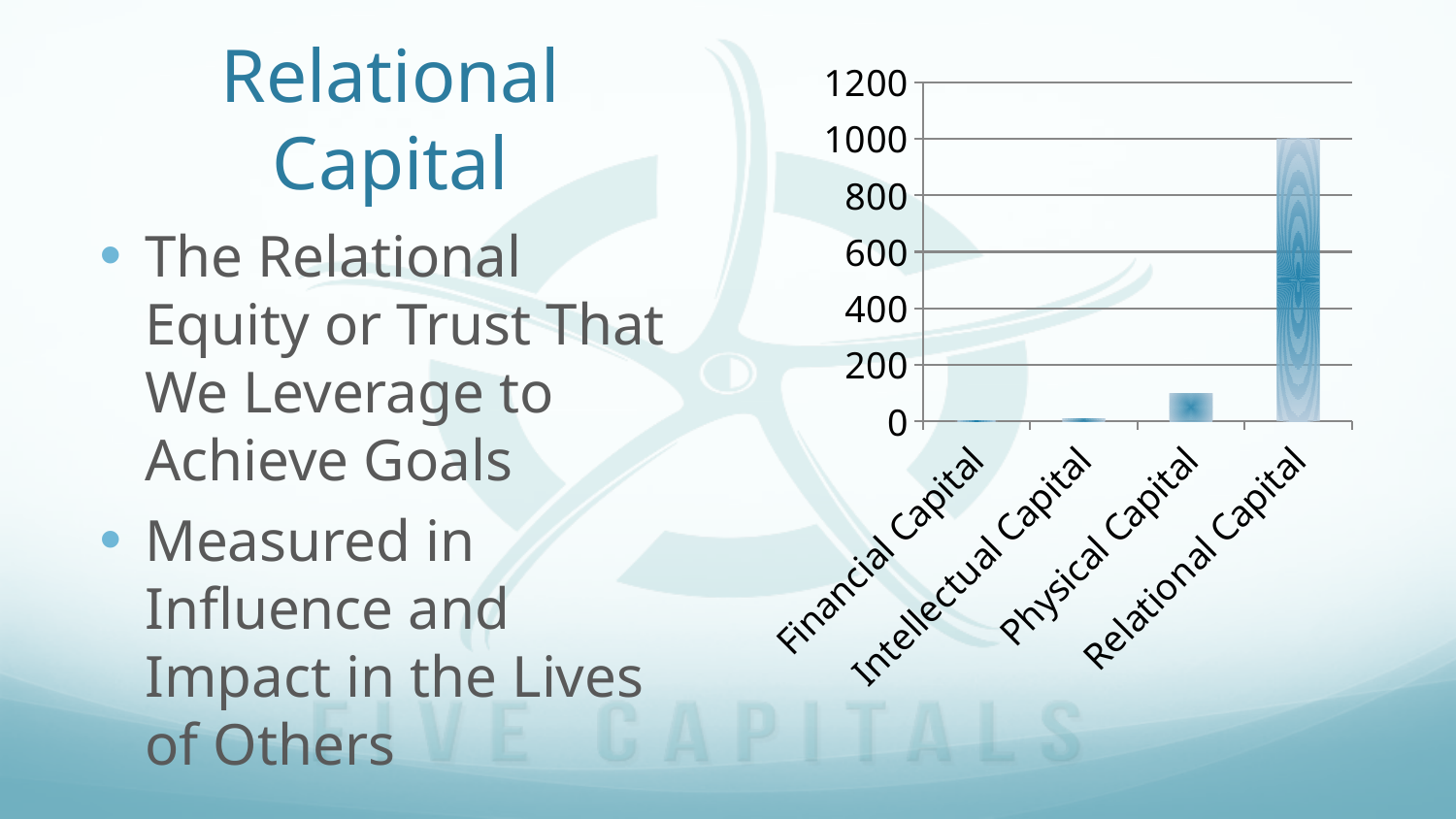
What is the value for Relational Capital in the chart? 1000 What kind of chart is shown on the slide? bar chart How many categories are shown on the x axis of the chart? 4 Is the value for Relational Capital greater or less than 800? greater What is the label of the rightmost category on the x axis? Relational Capital Which is larger, the value for Relational Capital or the value for Physical Capital? Relational Capital Do the values rise or fall from left to right along the x axis? rise Is the value for Physical Capital greater or less than 200? less Which is larger, the value for Physical Capital or the value for Intellectual Capital? Physical Capital What is the highest value shown on the y axis of the chart? 1200 Which category has the highest value in the chart? Relational Capital Is the value for Intellectual Capital greater or less than 200? less